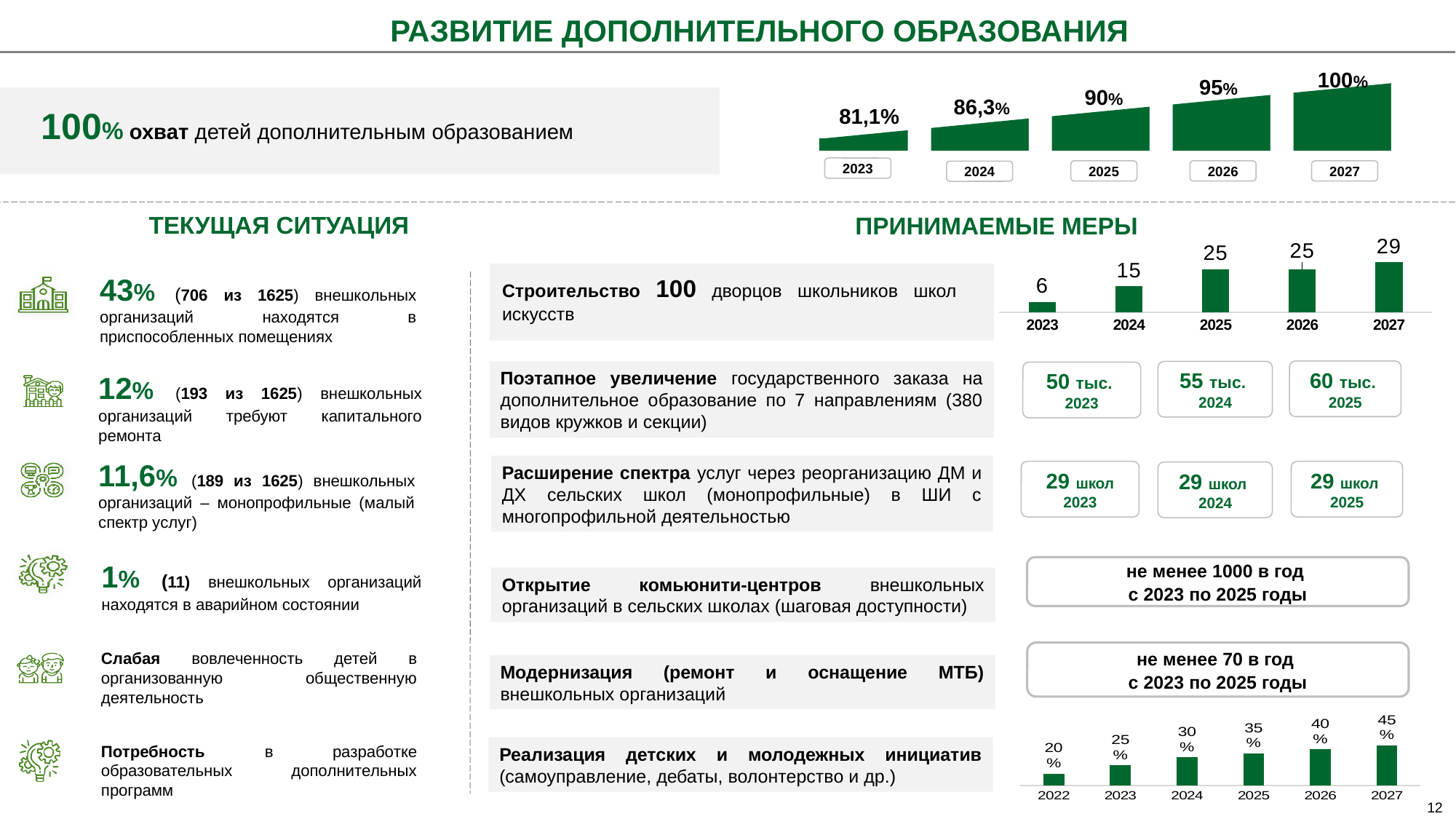
In the bar chart next to the 'Строительство 100 дворцов школьников' row, how many years are shown? 5 In the bottom-right bar chart, what is the value for 2022? 20% What type of chart is the bottom-right chart? bar chart In the top-right coverage chart, what is the value for 2027? 100% In the top-right coverage chart, what is the difference between the 2026 and 2025 values? 5% In the bottom-right bar chart, how many years are shown on the x axis? 6 In the bar chart next to the 'Строительство 100 дворцов школьников' row, which year has the highest value? 2027 In the top-right coverage chart, do the values rise or fall from 2023 to 2027? rise In the top-right coverage chart, which year has the lowest value? 2023 In the bar chart at the right of the 'Строительство 100 дворцов школьников школ искусств' row, what is the value for 2024? 15 In the top-right chart showing coverage of children by additional education, what is the value for 2024? 86,3% In the bar chart next to the 'Строительство 100 дворцов школьников' row, what is the difference between the 2025 and 2023 values? 19